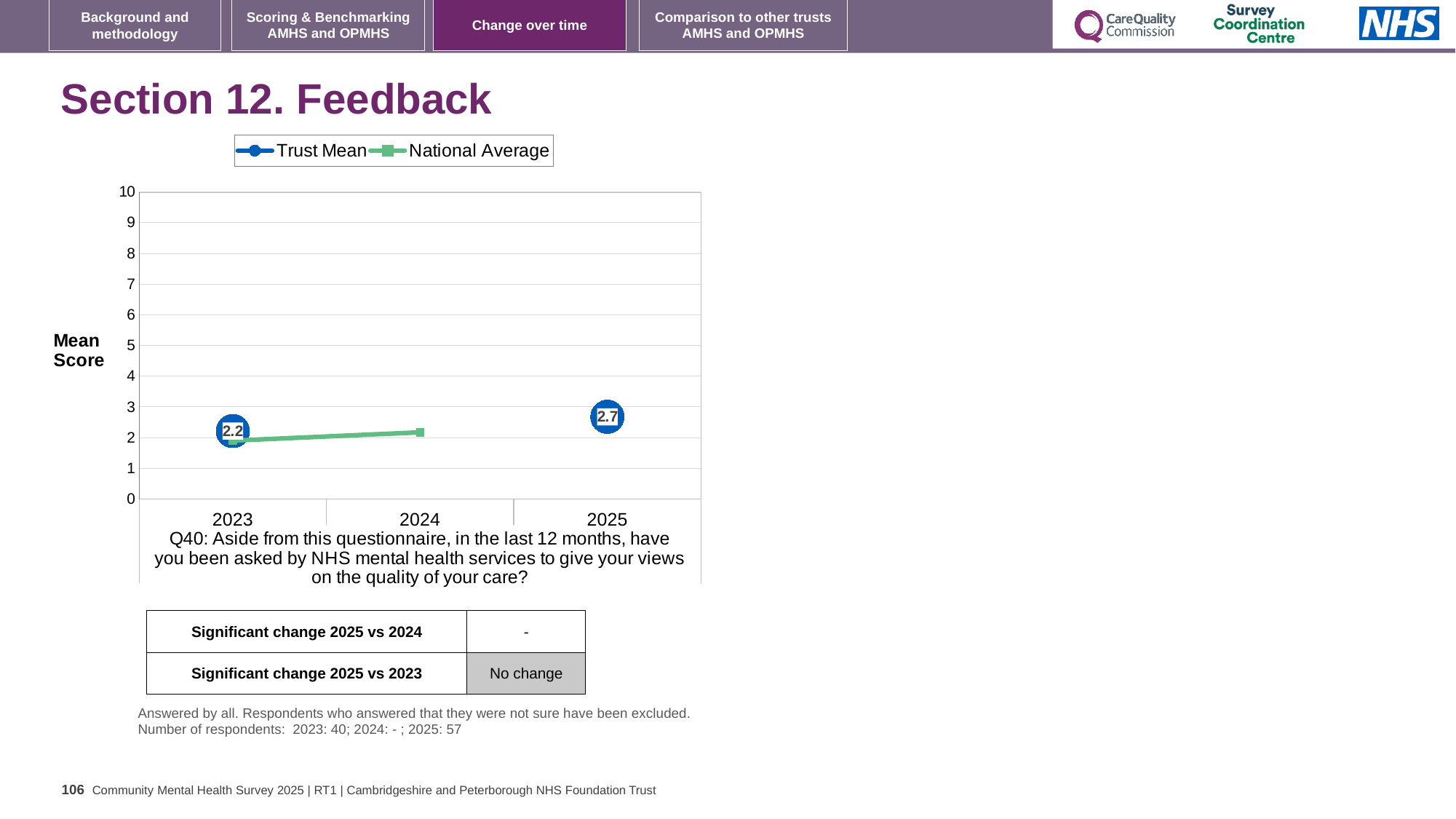
Does the Trust Mean rise or fall from 2023 to 2025? Rise In which year is the Trust Mean highest? 2025 By how much did the Trust Mean change between 2023 and 2025? 0.5 What is the label on the y axis of the chart? Mean Score What is the Trust Mean value for 2025? 2.7 Is the Trust Mean for 2025 greater or less than 3? less How many years are shown on the x axis of the chart? 3 How many series does the chart legend list? 2 Which year has the higher Trust Mean, 2023 or 2025? 2025 What is the Trust Mean value for 2023? 2.2 Is the National Average for 2023 greater or less than 3? less What kind of chart is shown on the slide? Line chart